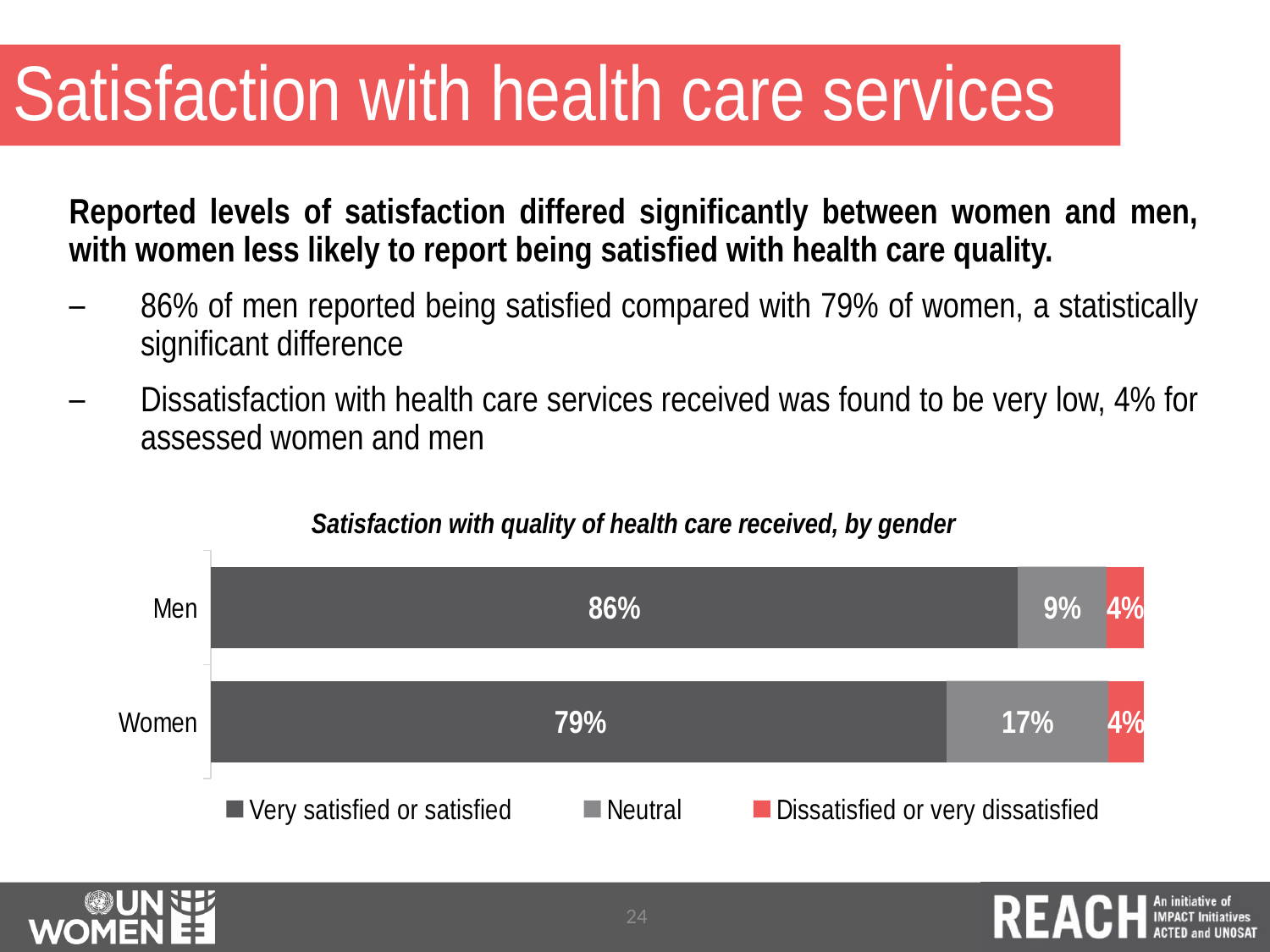
What type of chart is shown on the slide? Stacked bar chart What is the difference between the Neutral values for women and men? 8% How many categories are shown on the chart? 2 What percentage of men are dissatisfied or very dissatisfied? 4% What is the Neutral value for men? 9% What is the Neutral value for women? 17% What percentage of men are very satisfied or satisfied with the quality of health care received? 86% How many series does the legend list? 3 What percentage of women are very satisfied or satisfied with the quality of health care received? 79% What is the difference between the very satisfied or satisfied values for men and women? 7% Which gender has the higher share of very satisfied or satisfied respondents? Men Is the Neutral value larger for men or for women? Women